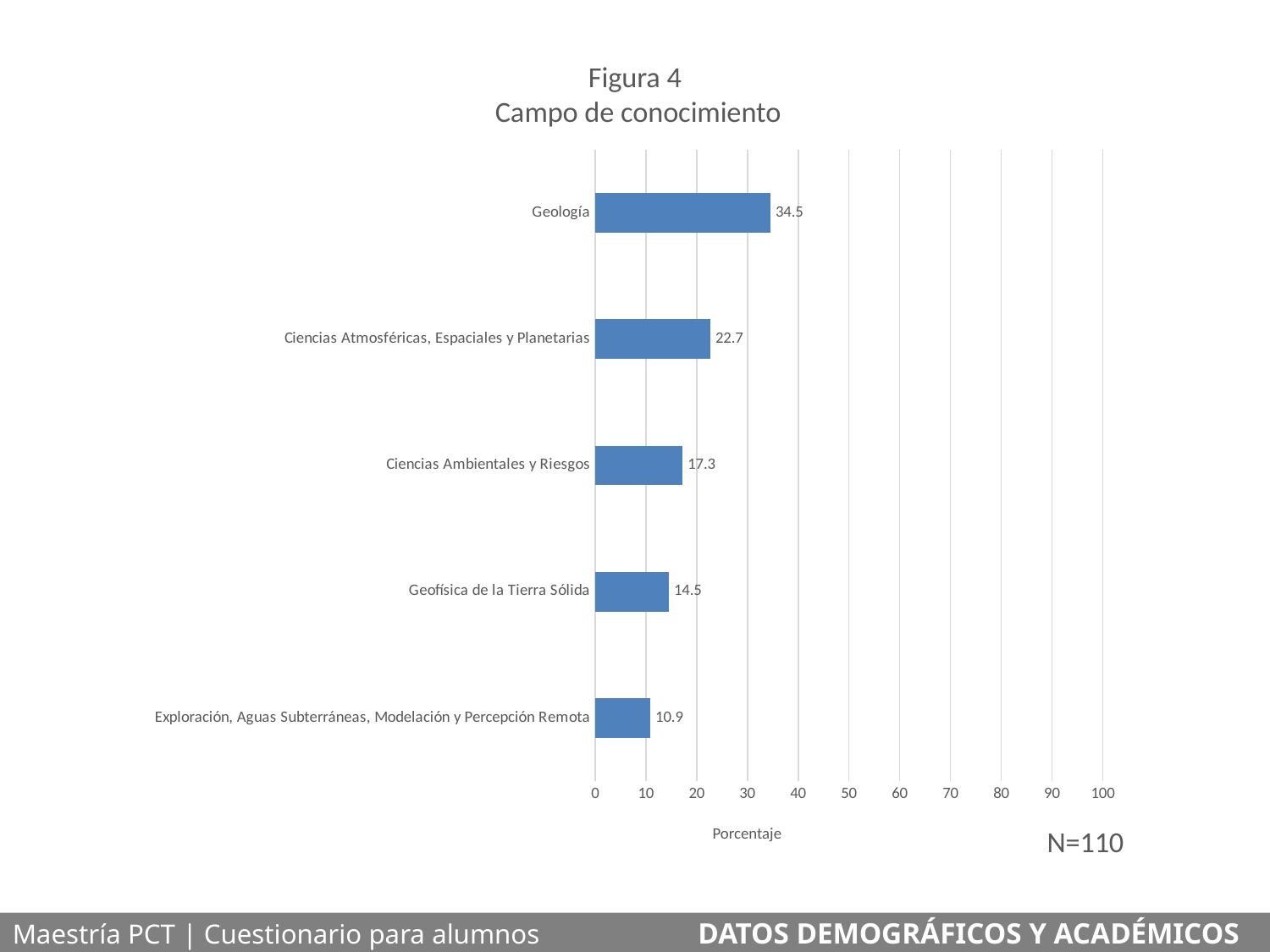
What is the value for Ciencias Atmosféricas, Espaciales y Planetarias? 22.7 What is the difference between the values for Geología and Ciencias Ambientales y Riesgos? 17.2 What kind of chart is shown on the slide? bar chart What is the title of the chart? Figura 4 Campo de conocimiento What is the label of the horizontal axis? Porcentaje Which is larger, the value for Ciencias Ambientales y Riesgos or the value for Geofísica de la Tierra Sólida? Ciencias Ambientales y Riesgos What is the value for Geofísica de la Tierra Sólida? 14.5 What is the value for Geología? 34.5 How many categories are shown in the chart? 5 Which category has the highest value? Geología Which category has the lowest value? Exploración, Aguas Subterráneas, Modelación y Percepción Remota Is the value for Ciencias Atmosféricas, Espaciales y Planetarias greater or less than 30? less